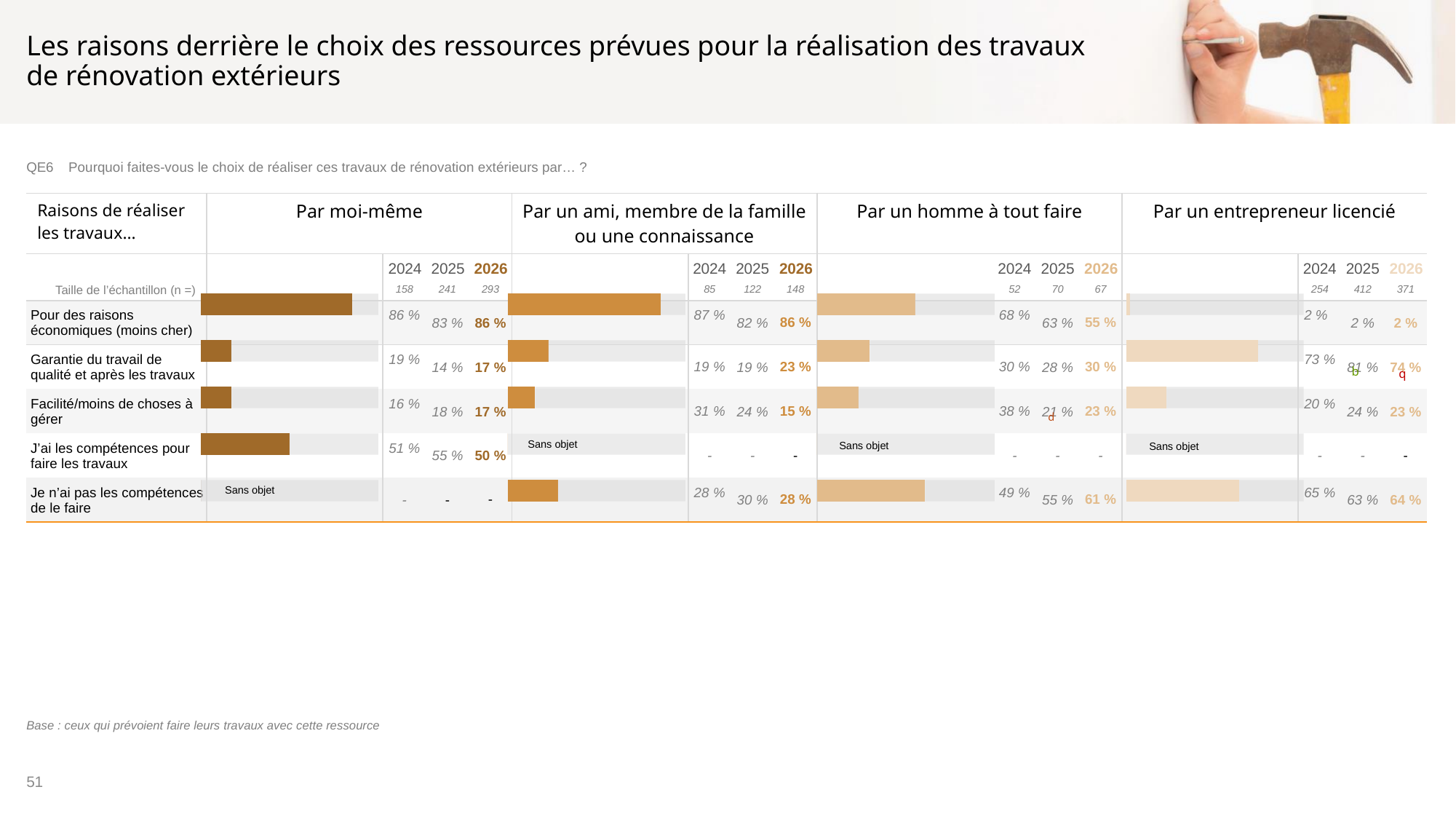
In the 'Par un homme à tout faire' chart, does the value for 'Pour des raisons économiques (moins cher)' rise or fall from 2024 to 2026? Fall In the 'Par un homme à tout faire' chart, which reason has the highest 2026 value? Je n'ai pas les compétences de le faire How many years of data are shown for each resource type? 3 What kind of chart is used in each of the four panels on the slide? Bar chart How many reasons (row categories) are listed in the table? 5 In the 'Par moi-même' chart, which reason is marked 'Sans objet'? Je n'ai pas les compétences de le faire In the 'Par un ami, membre de la famille ou une connaissance' chart, what is the difference between the 2024 and 2026 values for 'Facilité/moins de choses à gérer'? 16 percentage points What is the 2026 sample size (n) for 'Par un entrepreneur licencié'? 371 In the 'Par un entrepreneur licencié' chart, which reason has the lowest 2026 value? Pour des raisons économiques (moins cher) In the 'Par moi-même' chart, what is the 2026 value for 'Pour des raisons économiques (moins cher)'? 86 % In the 'Par moi-même' chart, which has the larger 2026 value: 'Garantie du travail de qualité et après les travaux' or 'J'ai les compétences pour faire les travaux'? J'ai les compétences pour faire les travaux In the 'Par un entrepreneur licencié' chart, what is the 2025 value for 'Garantie du travail de qualité et après les travaux'? 81 %